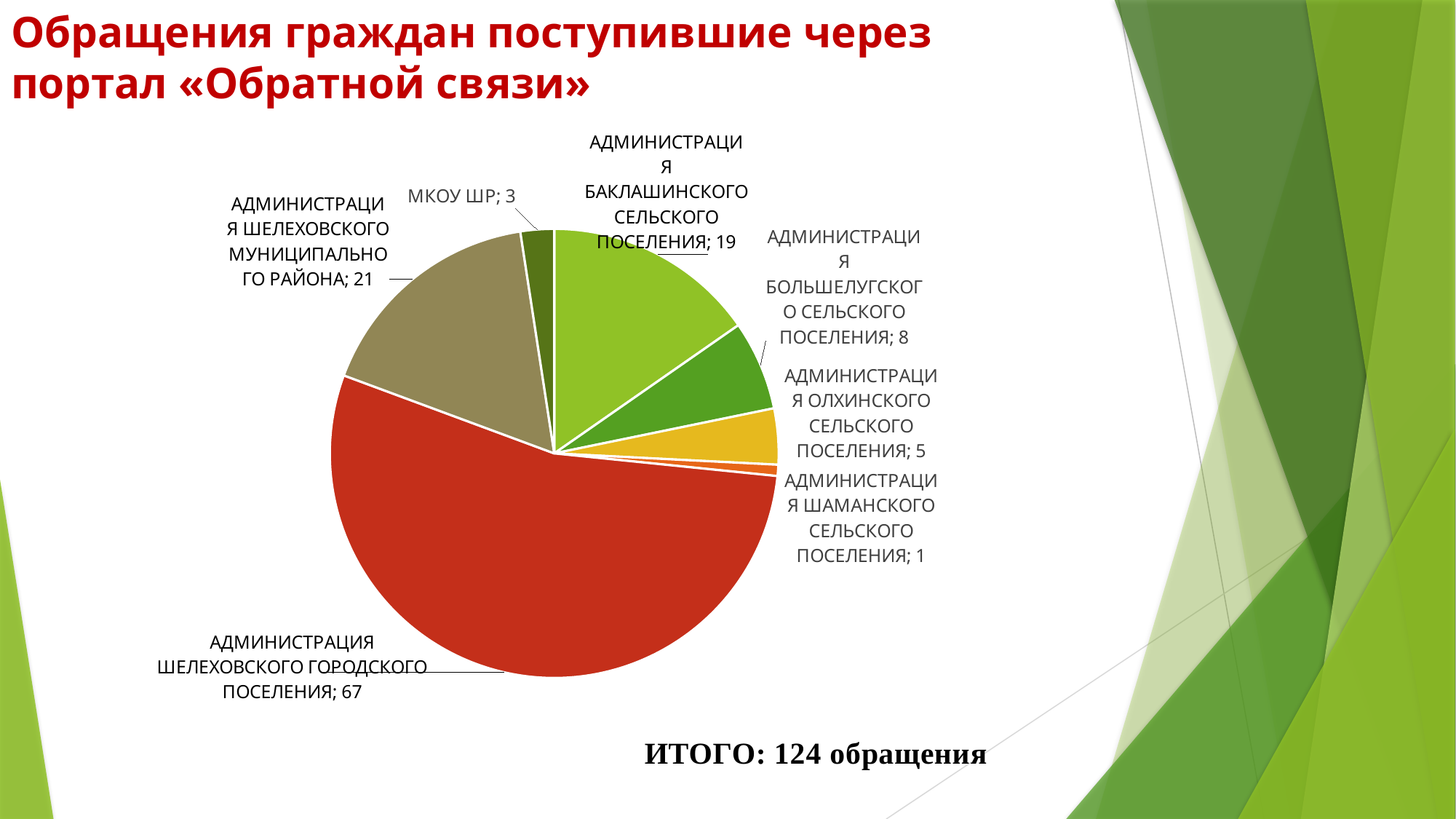
What is the value for Администрация Олхинского сельского поселения? 5 How many slices does the pie chart have? 7 What is the difference between the values for Администрация Шелеховского муниципального района and Администрация Баклашинского сельского поселения? 2 What type of chart is shown on the slide? pie chart What is the title of the slide? Обращения граждан поступившие через портал «Обратной связи» Which category has the largest slice of the pie? Администрация Шелеховского городского поселения What is the value for Администрация Баклашинского сельского поселения? 19 What total number of appeals is stated on the slide? 124 обращения What is the value for МКОУ ШР? 3 Which category has the smallest slice of the pie? Администрация Шаманского сельского поселения How many appeals are shown for Администрация Шелеховского городского поселения? 67 Which is larger: the value for Администрация Большелугского сельского поселения or Администрация Олхинского сельского поселения? Администрация Большелугского сельского поселения